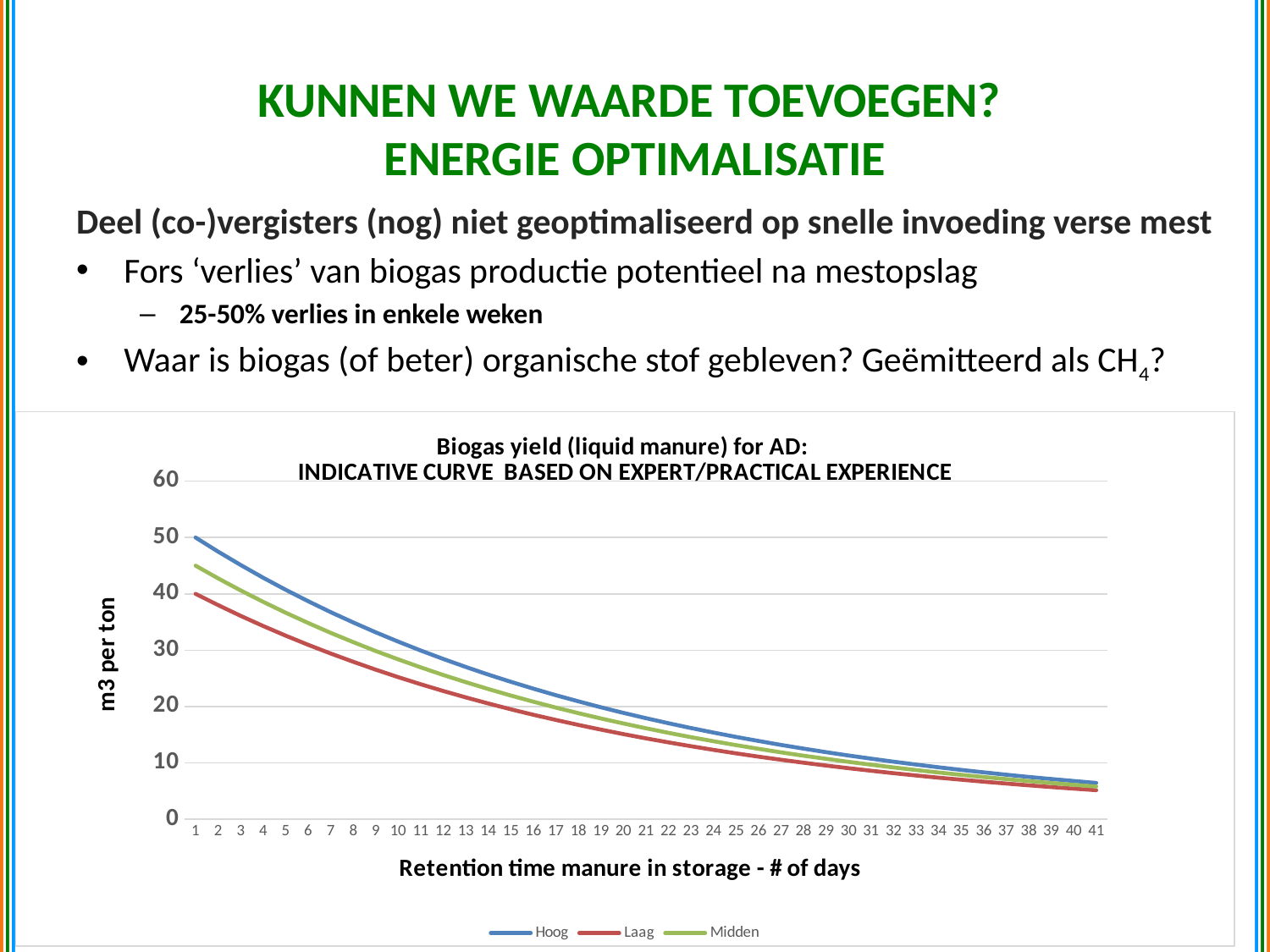
Which series has the highest value at day 1? Hoog How many series does the legend list? 3 Is the value for Hoog at day 41 greater or less than 10? less What is the label of the y axis? m3 per ton Do the values rise or fall as the retention time increases along the x axis? fall What is the value of the Laag series at day 1? 40 Which series has the lowest value at day 1? Laag At day 10, which series has the larger value, Hoog or Laag? Hoog Is the value for Laag at day 20 greater or less than 20? less What kind of chart is shown on the slide? line chart What is the value of the Hoog series at day 1? 50 Is the value for Hoog at day 10 greater or less than 30? greater